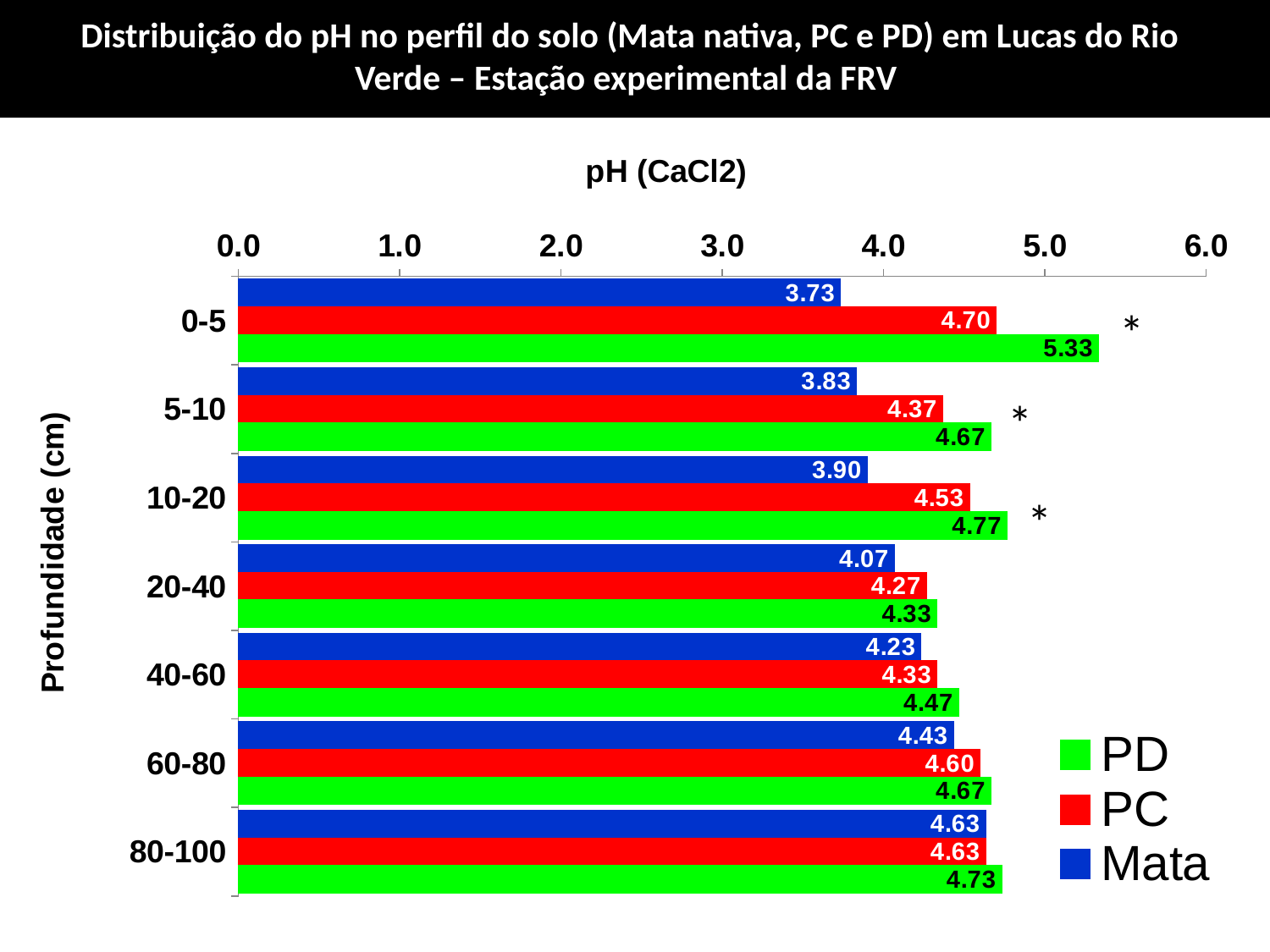
At which depth does the Mata series have its lowest pH value? 0-5 At which depth does the PD series reach its highest pH value? 0-5 What is the difference between the PD and Mata pH values at the 0-5 cm depth? 1.60 What is the pH value for PD at the 80-100 cm depth? 4.73 What is the pH value for PC at the 10-20 cm depth? 4.53 Which colour represents the PC series in the legend? Red What is the pH value for PD at the 0-5 cm depth? 5.33 How many depth categories are shown on the chart? 7 Which is larger at the 5-10 cm depth, the PC value or the Mata value? PC What kind of chart is shown on the slide? Bar chart What is the pH value for Mata at the 0-5 cm depth? 3.73 How many series does the legend list? 3